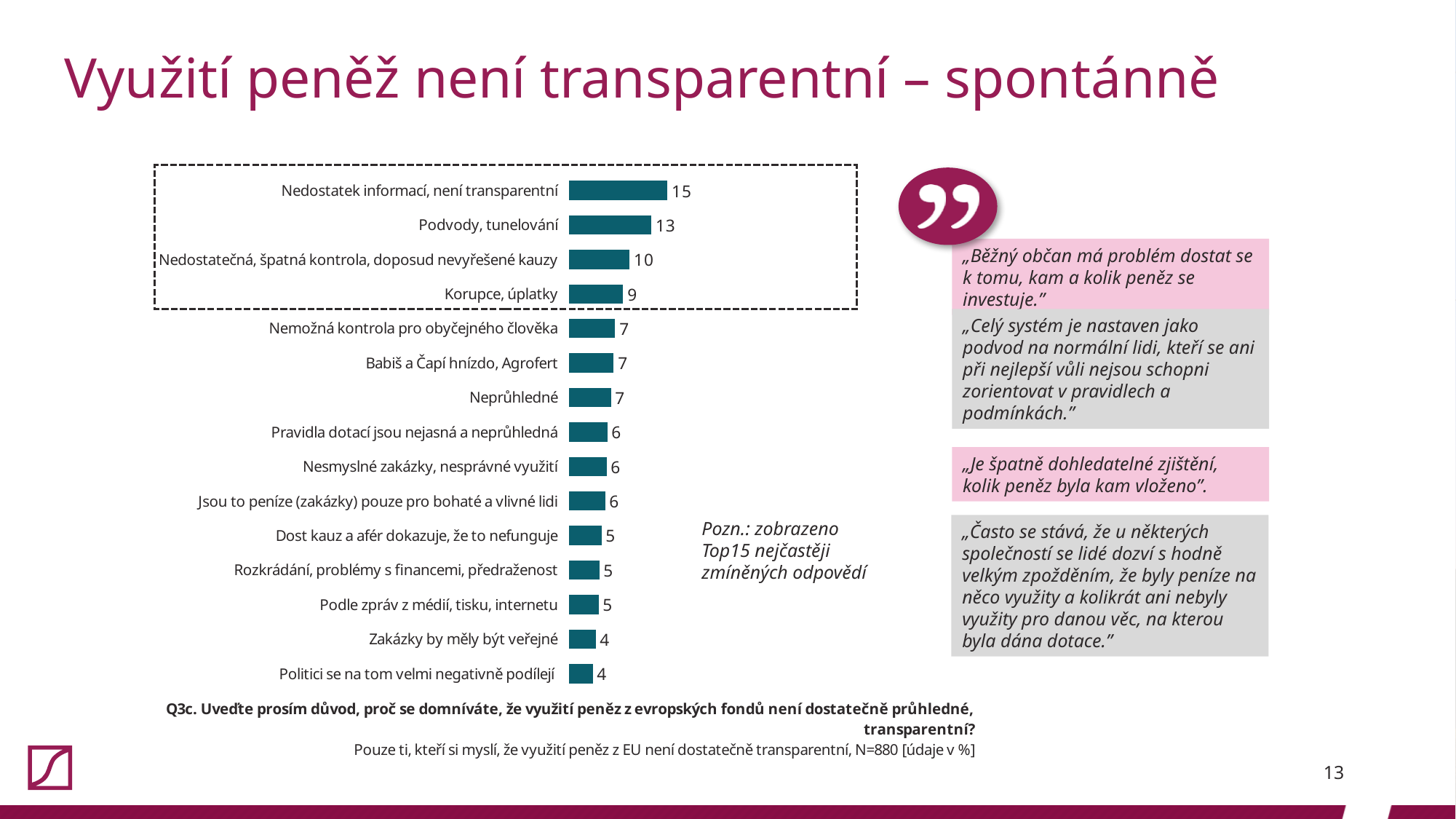
What is the value for "Babiš a Čapí hnízdo, Agrofert"? 7 How many categories are enclosed in the dashed box at the top of the chart? 4 What is the difference between the values for "Nedostatečná, špatná kontrola, doposud nevyřešené kauzy" and "Zakázky by měly být veřejné"? 6 What is the value for "Korupce, úplatky"? 9 How many categories are shown in the bar chart? 15 What is the difference between the values for "Nedostatek informací, není transparentní" and "Podvody, tunelování"? 2 Which category has the highest value? Nedostatek informací, není transparentní What kind of chart is shown on the slide? Bar chart What is the value for "Nedostatek informací, není transparentní"? 15 What is the value for "Politici se na tom velmi negativně podílejí"? 4 Which is larger: the value for "Podvody, tunelování" or the value for "Nemožná kontrola pro obyčejného člověka"? Podvody, tunelování What is the value for "Podle zpráv z médií, tisku, internetu"? 5